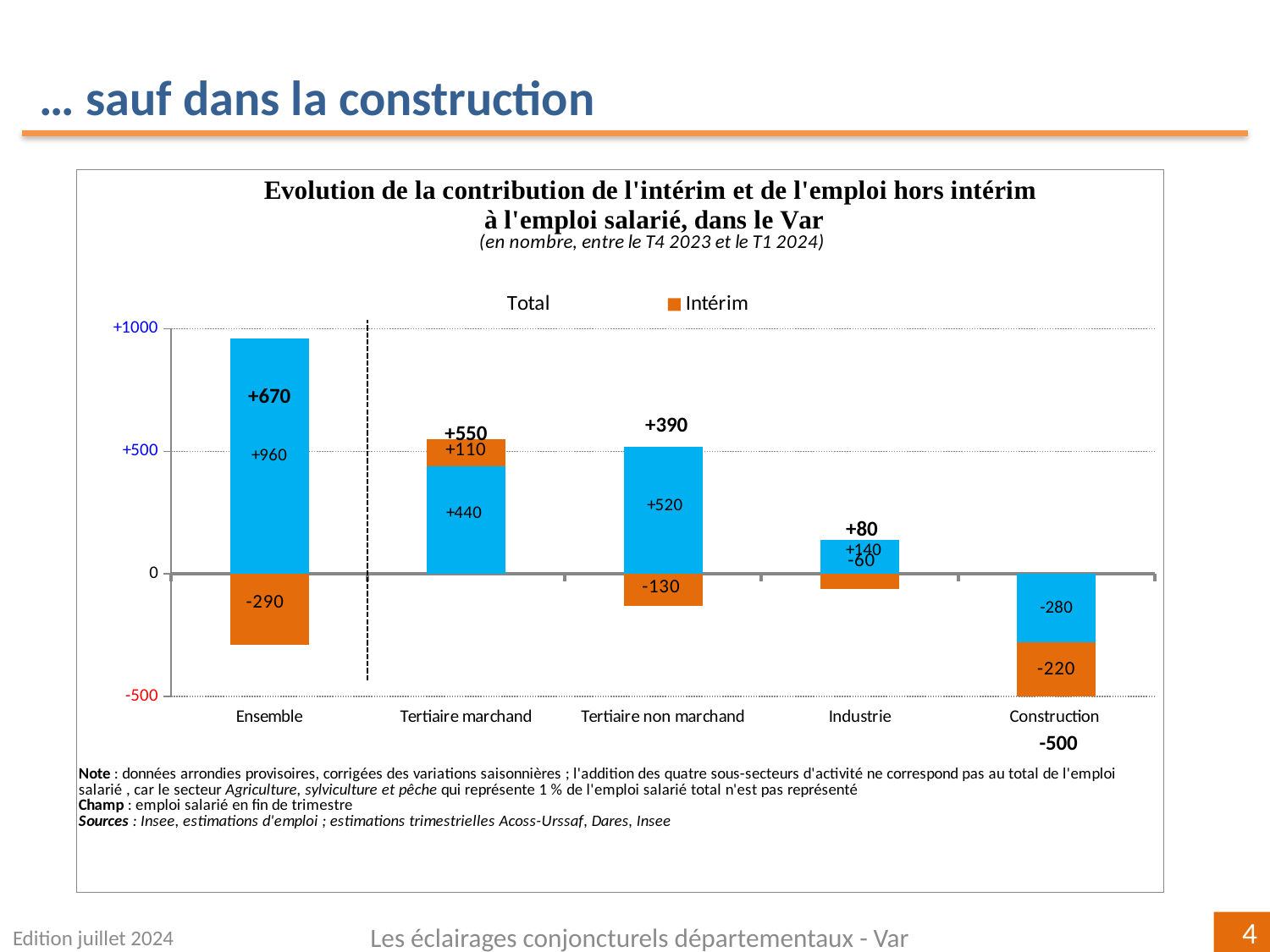
What is the difference between the Intérim value for Construction (-220) and for Industrie (-60)? 160 Which category has the lowest total value? Construction What kind of chart is shown on the slide? Bar chart Which category has the highest total value? Ensemble What is the Intérim value for Ensemble? -290 What value is printed on the blue bar for Tertiaire non marchand? +520 Which is larger, the Intérim value for Tertiaire marchand or for Tertiaire non marchand? Tertiaire marchand What value is printed on the blue bar for Construction? -280 What is the total value shown for Industrie? +80 What is the total value shown for Tertiaire marchand? +550 Is the value of the blue bar for Ensemble greater or less than +500? greater How many categories are shown on the x axis? 5